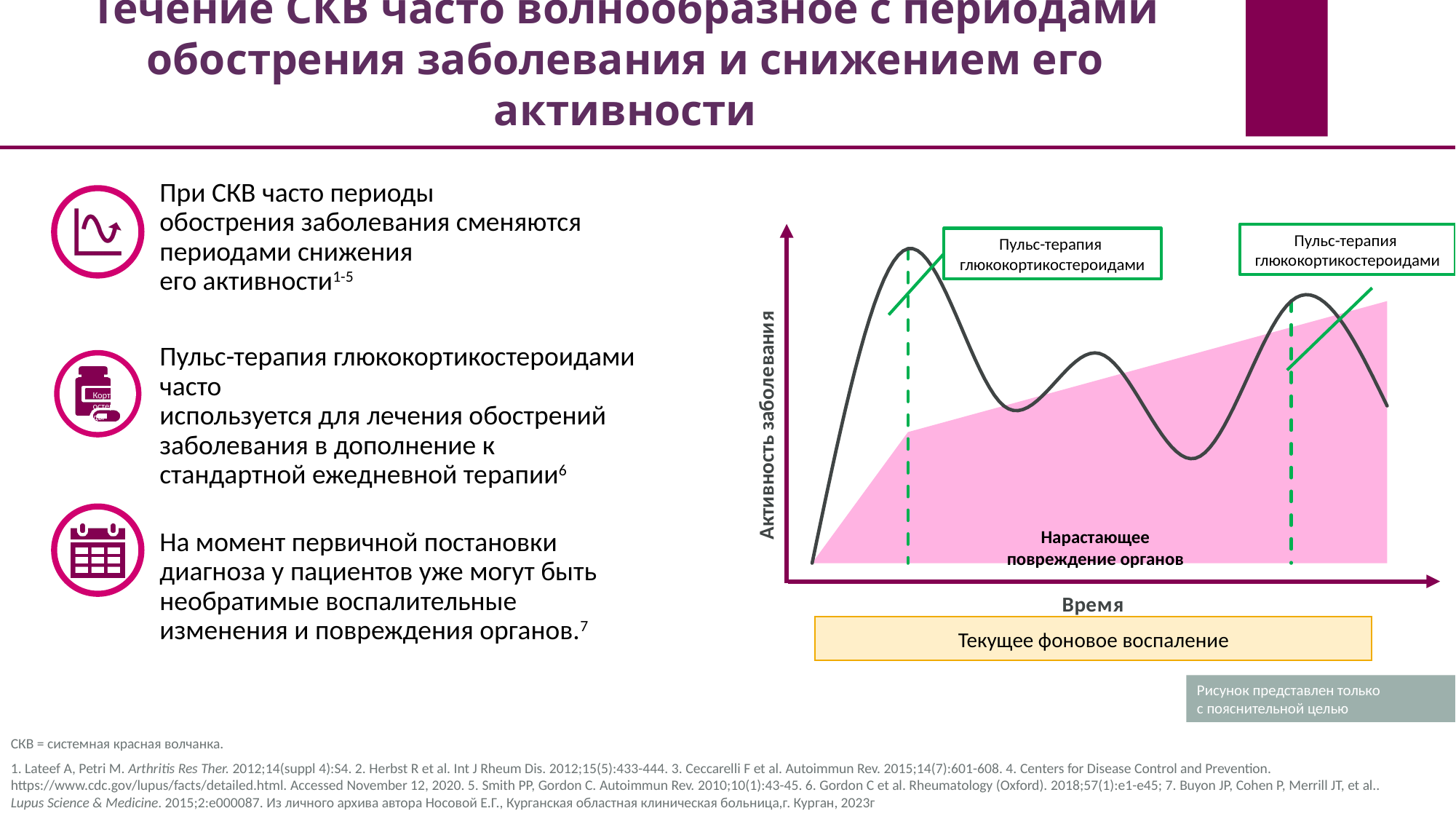
How many peaks does the disease activity curve have? 3 Which peak of the disease activity curve is the lowest: the first, second or third? the second What kind of chart is shown on the right side of the slide? line chart How many pulse-therapy (Пульс-терапия глюкокортикостероидами) interventions are marked on the chart with dashed vertical lines? 2 Is the second peak of the disease activity curve higher or lower than the third peak? lower Does the shaded area labelled 'Нарастающее повреждение органов' rise or fall along the time axis? rises Which peak of the disease activity curve is the highest: the first, second or third? the first What is the label of the vertical axis of the chart? Активность заболевания Is the first peak of the disease activity curve higher or lower than the third peak? higher What is the label of the horizontal axis of the chart? Время